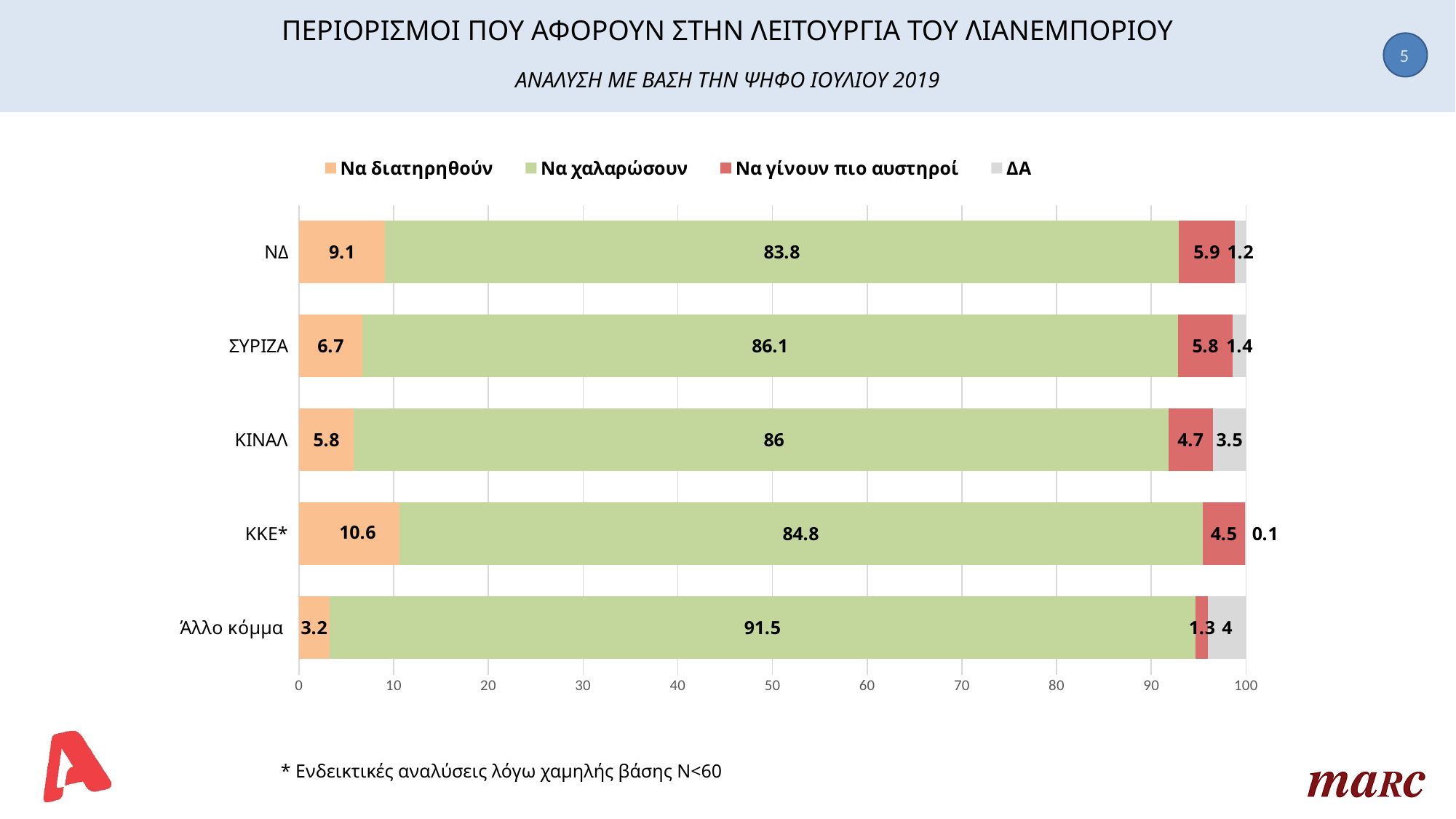
What is the value of "Να διατηρηθούν" for ΚΚΕ*? 10.6 Which category has the highest value for "Να χαλαρώσουν"? Άλλο κόμμα Which category has the lowest value for "Να διατηρηθούν"? Άλλο κόμμα Which is larger: the "Να γίνουν πιο αυστηροί" value for ΝΔ or for ΚΙΝΑΛ? ΝΔ What kind of chart is shown on the slide? Stacked bar chart Which legend entry is shown in green? Να χαλαρώσουν How many categories (parties) are shown on the chart? 5 How many series does the legend list? 4 What is the value of "Να γίνουν πιο αυστηροί" for Άλλο κόμμα? 1.3 What is the value of "Να χαλαρώσουν" for ΣΥΡΙΖΑ? 86.1 What is the difference between the "Να διατηρηθούν" values for ΚΚΕ* and ΝΔ? 1.5 What is the value of "ΔΑ" for ΚΙΝΑΛ? 3.5